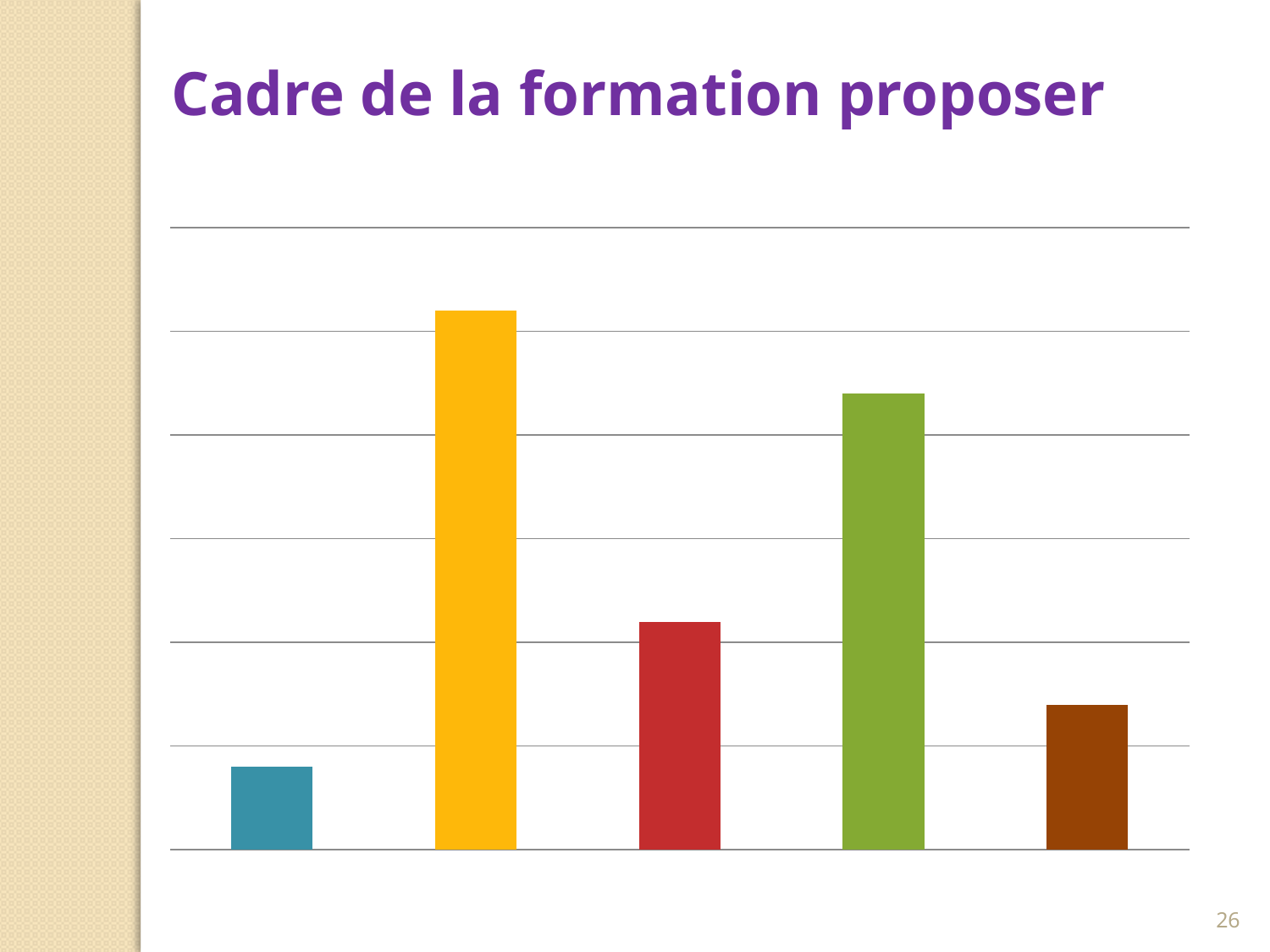
What colour is the shortest bar in the chart? blue What colour is the tallest bar in the chart? yellow Which bar is the tallest in the chart: the first, second, third, fourth or fifth from the left? second Does the chart display a legend? No What kind of chart is shown on the slide? bar chart Which is taller, the blue bar or the brown bar? brown bar Which is taller, the red bar or the brown bar? red bar Which is taller, the yellow bar or the green bar? yellow bar Which bar is the shortest in the chart: the first, second, third, fourth or fifth from the left? first What is the title shown above the chart on the slide? Cadre de la formation proposer How many bars does the chart show? 5